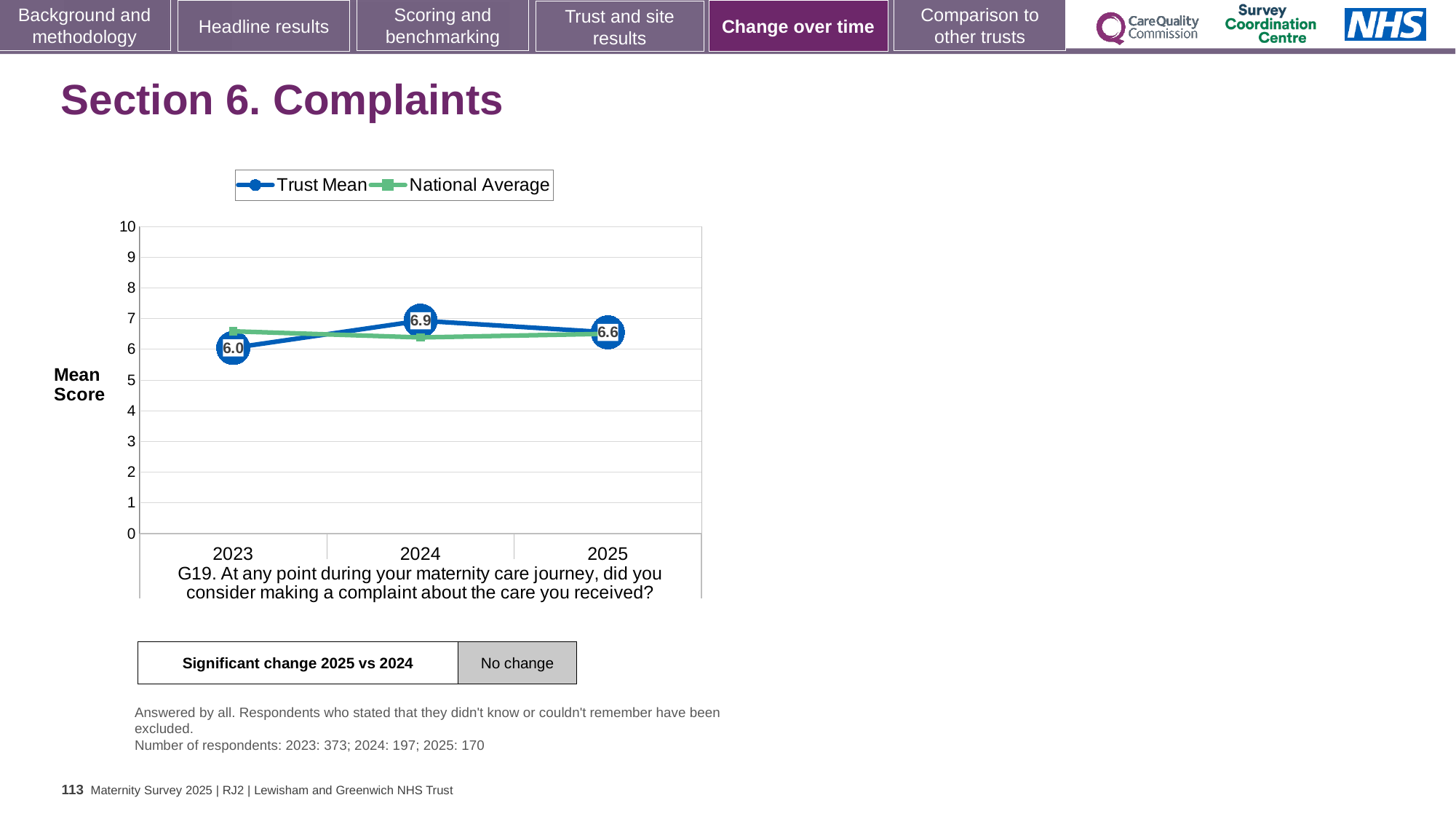
How many years are plotted on the x axis? 3 In which year is the Trust Mean highest? 2024 Did the Trust Mean rise or fall from 2024 to 2025? Fall What is the Trust Mean value for 2024? 6.9 How many series does the legend list? 2 What kind of chart is shown on the slide? Line chart In which year is the Trust Mean lowest? 2023 What is the Trust Mean value for 2025? 6.6 Which is larger, the Trust Mean for 2023 or for 2025? 2025 What is the Trust Mean value for 2023? 6.0 Is the National Average value for 2023 greater or less than 6? greater What is the difference between the Trust Mean in 2024 and in 2023? 0.9